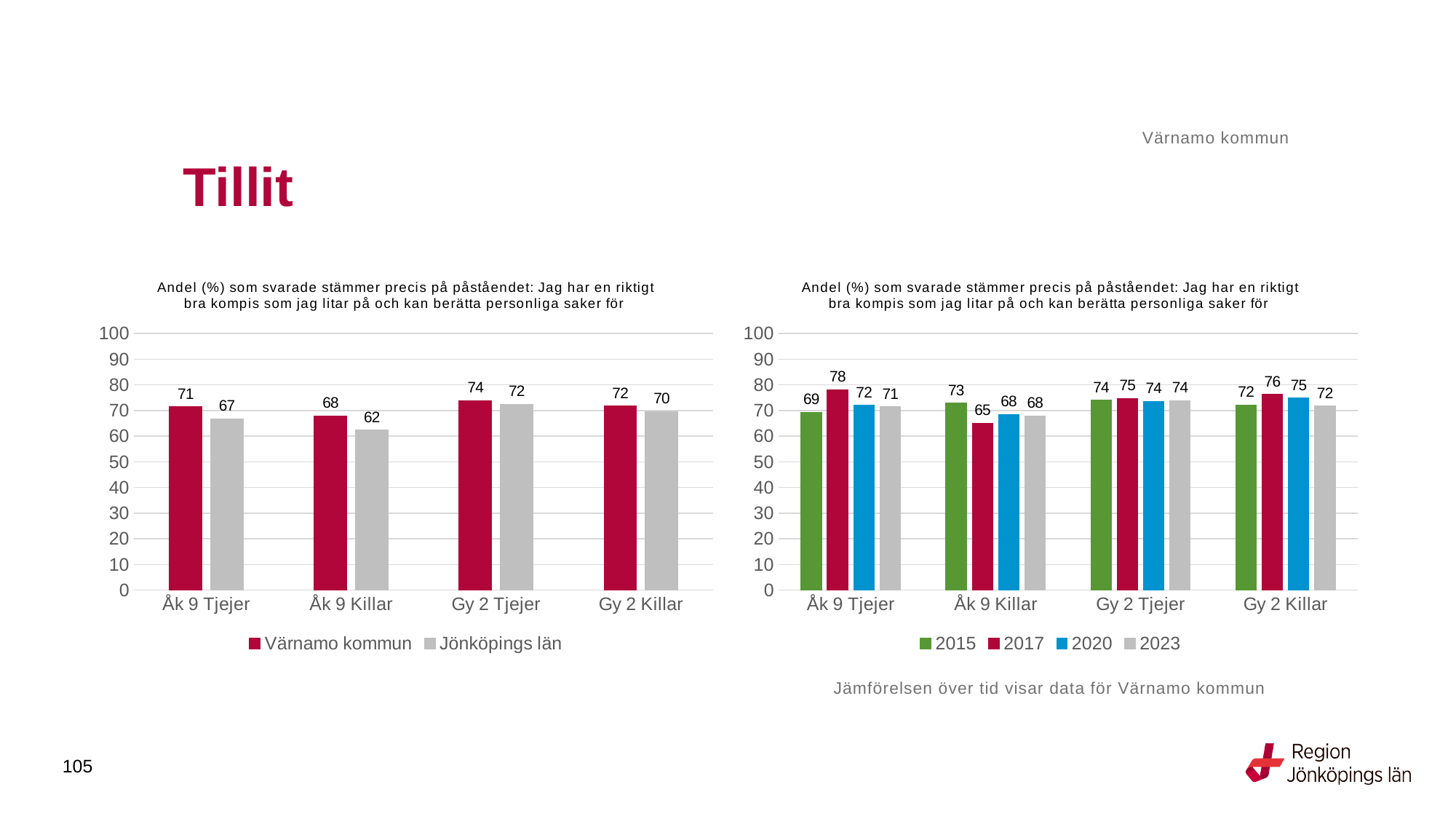
In the left chart, which category has the lowest value for Jönköpings län? Åk 9 Killar In the right chart, how many categories are shown on the x axis? 4 In the right chart, which category has the lowest value for 2017? Åk 9 Killar In the left chart, how many series does the legend list? 2 In the right chart, what is the value for 2023 for Gy 2 Killar? 72 In the left chart, what is the value for Värnamo kommun for Åk 9 Killar? 68 In the right chart, what is the value for 2017 for Åk 9 Tjejer? 78 In the left chart, what is the value for Jönköpings län for Gy 2 Tjejer? 72 What kind of chart is the left chart? Bar chart In the right chart, how many series does the legend list? 4 In the right chart, which is larger for Åk 9 Tjejer: the 2015 value or the 2017 value? 2017 In the left chart, what is the difference between Värnamo kommun and Jönköpings län for Åk 9 Killar? 6